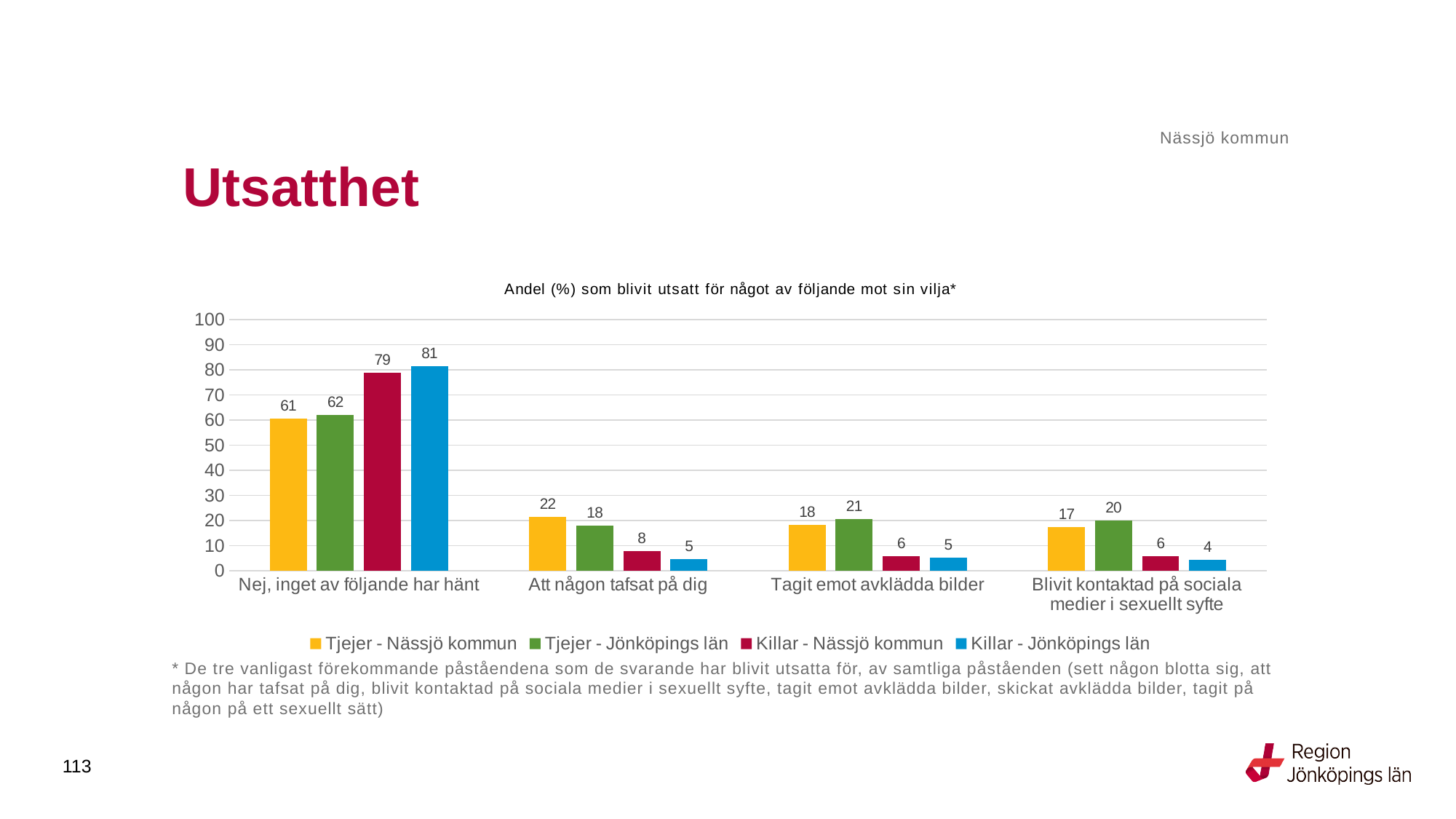
How many categories are shown on the x axis? 4 Which series has the lowest value in the category 'Blivit kontaktad på sociala medier i sexuellt syfte'? Killar - Jönköpings län Which is larger in the category 'Tagit emot avklädda bilder': Tjejer - Nässjö kommun or Tjejer - Jönköpings län? Tjejer - Jönköpings län What is the value for Tjejer - Nässjö kommun in the category 'Att någon tafsat på dig'? 22 What is the title of the chart? Andel (%) som blivit utsatt för något av följande mot sin vilja* What kind of chart is shown on the slide? Bar chart How many series does the legend list? 4 What is the value for Killar - Nässjö kommun in the category 'Blivit kontaktad på sociala medier i sexuellt syfte'? 6 Which series has the highest value in the category 'Nej, inget av följande har hänt'? Killar - Jönköpings län What is the difference between Killar - Nässjö kommun and Tjejer - Nässjö kommun in the category 'Nej, inget av följande har hänt'? 18 What is the value for Killar - Jönköpings län in the category 'Nej, inget av följande har hänt'? 81 What colour represents Killar - Nässjö kommun in the chart? Red